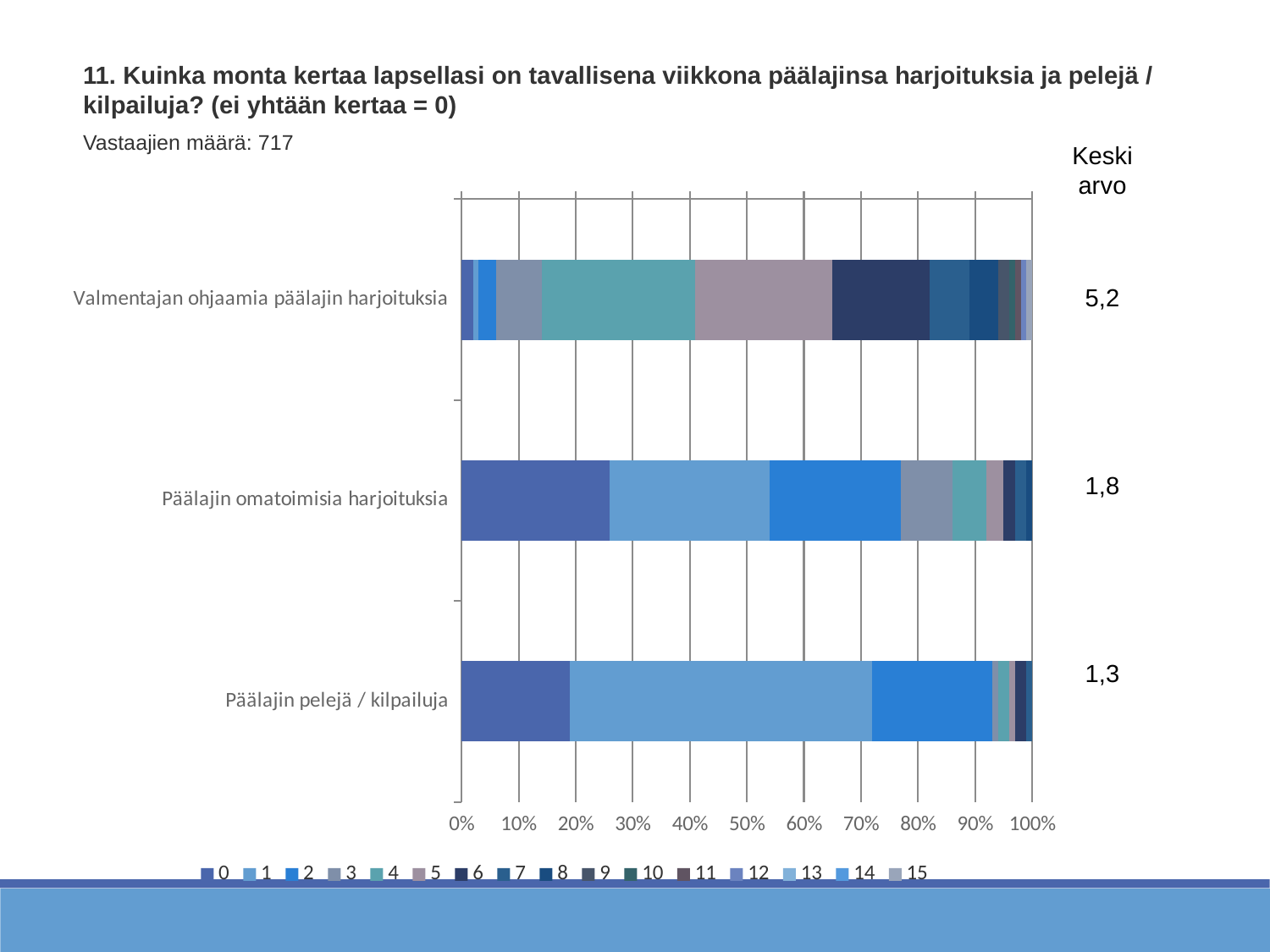
How many respondents (Vastaajien määrä) are reported on the slide? 717 What is the mean value (Keskiarvo) shown for Päälajin omatoimisia harjoituksia? 1,8 Which category has the lowest mean value (Keskiarvo)? Päälajin pelejä / kilpailuja What is the mean value (Keskiarvo) shown for Valmentajan ohjaamia päälajin harjoituksia? 5,2 What is the difference between the mean values of Valmentajan ohjaamia päälajin harjoituksia and Päälajin omatoimisia harjoituksia? 3,4 Which category has the highest mean value (Keskiarvo)? Valmentajan ohjaamia päälajin harjoituksia What is the mean value (Keskiarvo) shown for Päälajin pelejä / kilpailuja? 1,3 How many categories (bars) does the chart show? 3 What kind of chart is shown on the slide? stacked bar chart Is the share of the '1' segment in the Päälajin pelejä / kilpailuja bar greater or less than 50%? greater Is the share of the '0' segment in the Päälajin omatoimisia harjoituksia bar greater or less than 20%? greater How many series does the legend list? 16